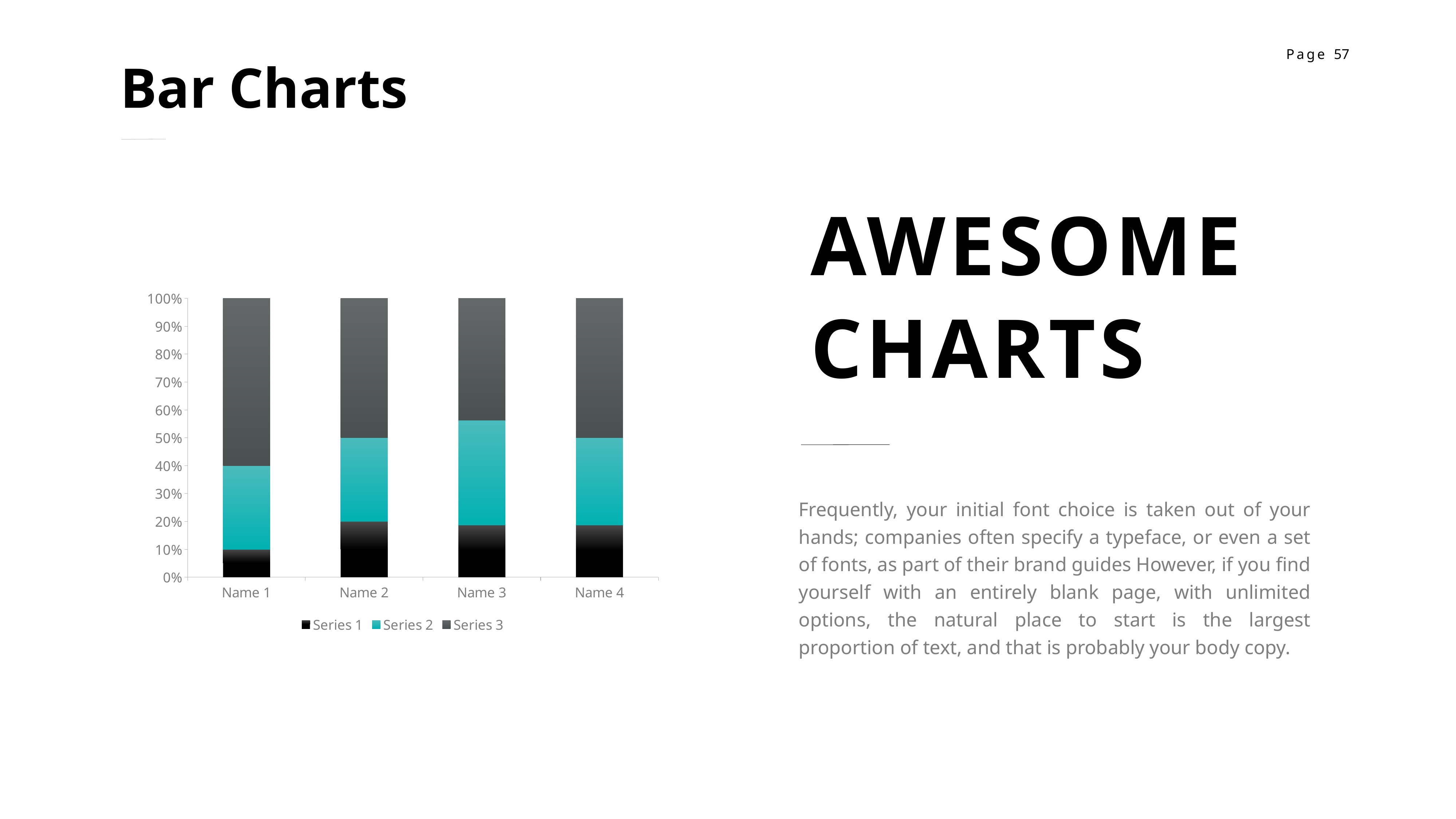
Is the value of Series 1 for Name 2 greater or less than 10%? greater What is the total height of the stacked bar for Name 1? 100% Is the value of Series 1 for Name 1 greater or less than 20%? less Which is larger, the Series 3 value for Name 1 or the Series 3 value for Name 3? Name 1 Which category has the smallest Series 1 segment? Name 1 Which is larger, the Series 1 value for Name 1 or the Series 1 value for Name 2? Name 2 What kind of chart is shown on the slide? Stacked bar chart How many categories are shown on the x axis of the chart? 4 How many series does the chart's legend list? 3 Is the value of Series 3 for Name 1 greater or less than 50%? greater What colour represents Series 2 in the chart? Teal